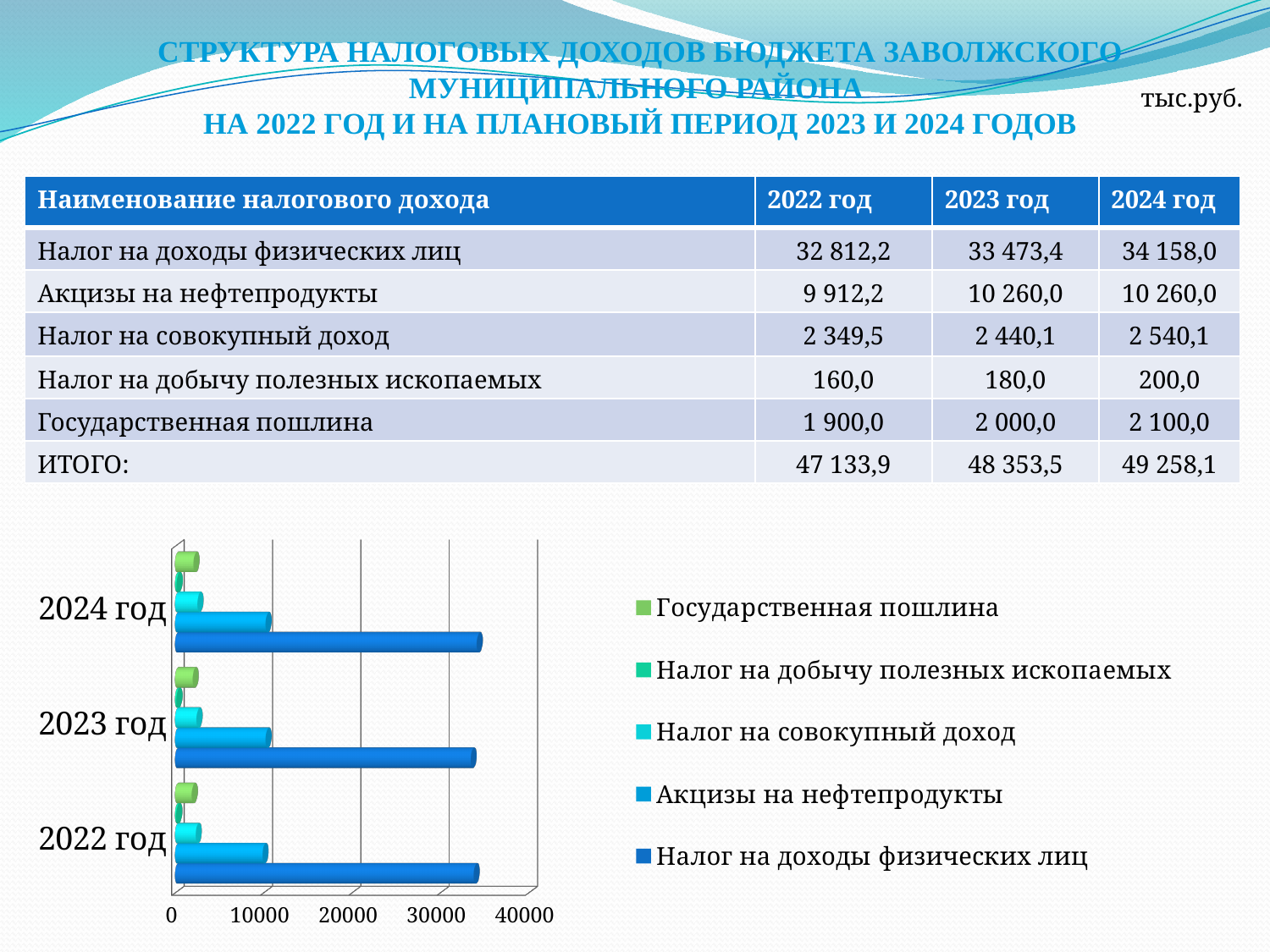
How many series does the chart legend list? 5 In the bar chart, is the value for Акцизы на нефтепродукты in 2022 год greater or less than 20000? less Which legend entry is shown in dark blue in the bar chart? Налог на доходы физических лиц According to the slide, what is the value of Государственная пошлина for 2024 год? 2 100,0 In the bar chart, which series has the shortest bar for 2024 год? Налог на добычу полезных ископаемых In the bar chart, for 2022 год, which is larger: Акцизы на нефтепродукты or Налог на совокупный доход? Акцизы на нефтепродукты What kind of chart is shown at the bottom of the slide? bar chart How many year categories does the bar chart show? 3 According to the slide, what is the value of Акцизы на нефтепродукты for 2023 год? 10 260,0 In the bar chart, which series has the longest bar for 2023 год? Налог на доходы физических лиц In the bar chart, is the value for Налог на доходы физических лиц in 2024 год greater or less than 30000? greater What is the highest tick value shown on the horizontal axis of the bar chart? 40000